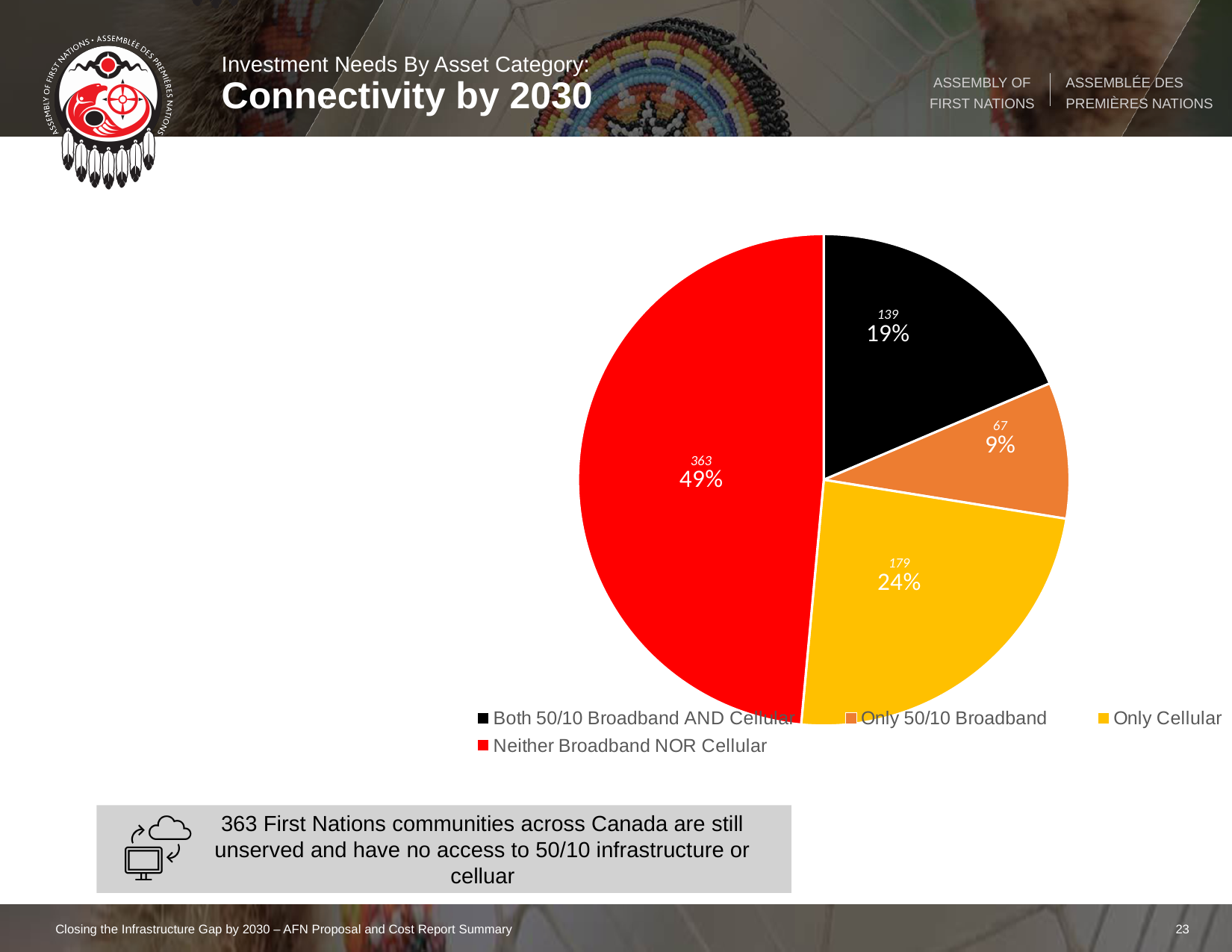
What kind of chart is shown on the slide? Pie chart How many slices does the pie chart have? 4 What percentage of the pie is 'Only Cellular'? 24% What colour is the 'Neither Broadband NOR Cellular' slice? Red Which is larger: the count for 'Only Cellular' or the count for 'Only 50/10 Broadband'? Only Cellular What is the difference between the counts for 'Only Cellular' and 'Both 50/10 Broadband AND Cellular'? 40 Which category has the largest slice of the pie? Neither Broadband NOR Cellular What percentage of the pie is 'Only 50/10 Broadband'? 9% What percentage of the pie is 'Both 50/10 Broadband AND Cellular'? 19% Which category has the smallest slice of the pie? Only 50/10 Broadband What is the count shown for 'Both 50/10 Broadband AND Cellular'? 139 What is the count shown for the 'Neither Broadband NOR Cellular' slice? 363